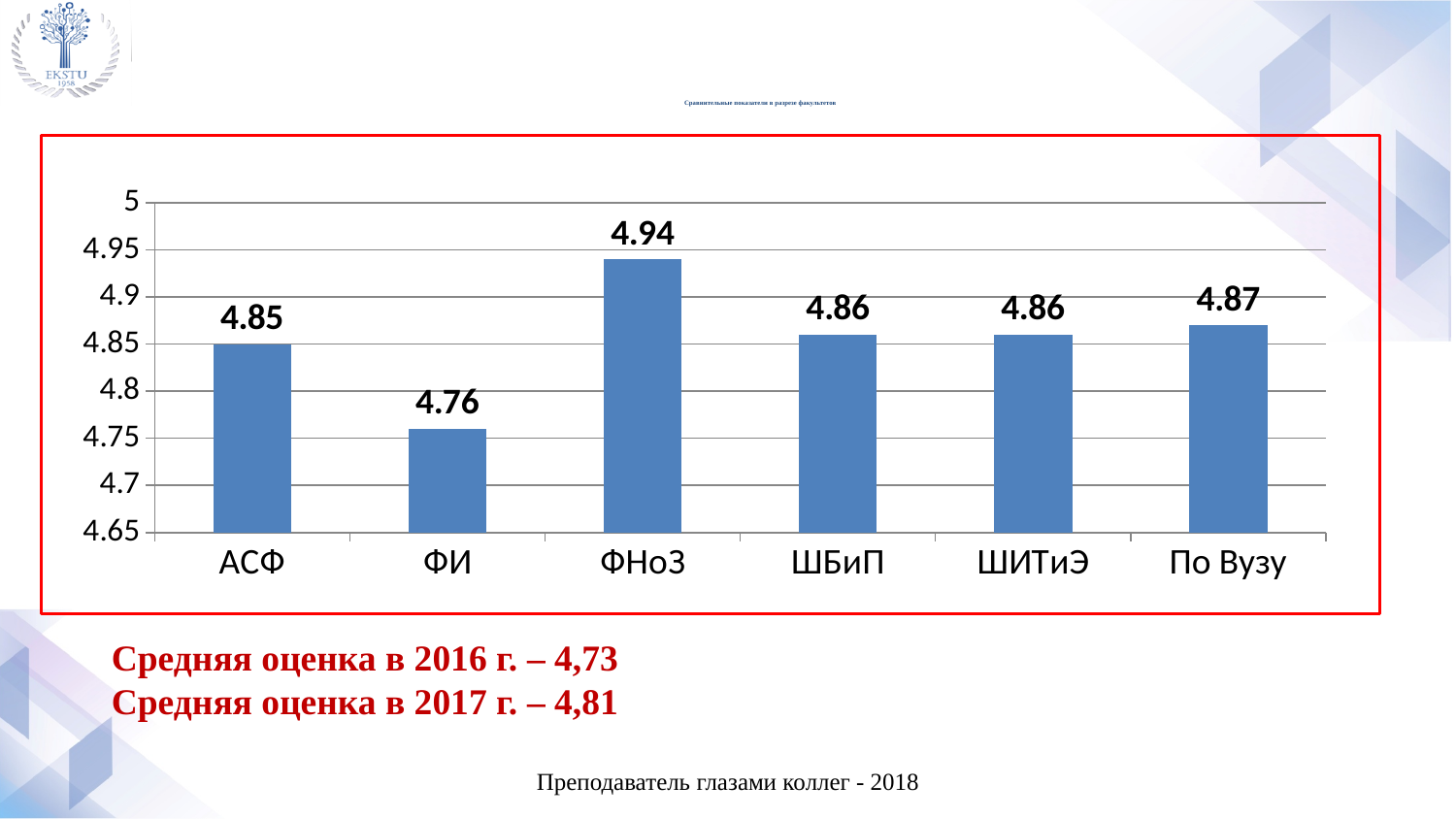
What is the value for По Вузу? 4.87 What is the value for ШБиП? 4.86 Which category has the highest value? ФНоЗ What is the difference between the values for ФНоЗ and ФИ? 0.18 What kind of chart is shown on the slide? bar chart What is the value for ФИ? 4.76 What is the value for АСФ? 4.85 Which is larger, the value for АСФ or the value for ФНоЗ? ФНоЗ Which category has the lowest value? ФИ What is the value for ФНоЗ? 4.94 Is the value for ФИ greater or less than 4.8? less How many categories are shown on the x axis? 6